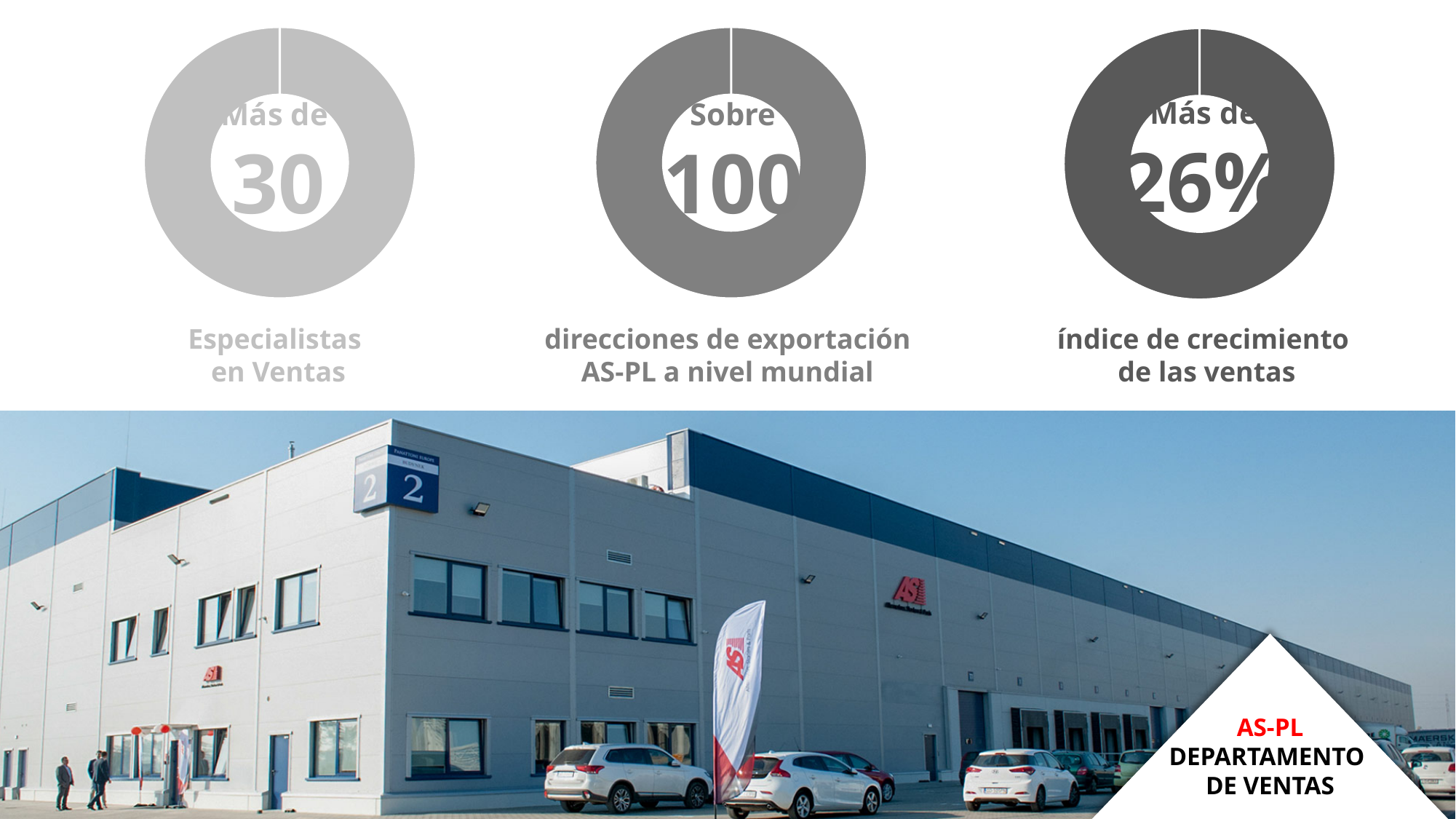
What kind of chart shapes are used to display the three figures at the top of the slide? Donut (ring) charts What value is shown in the right circle labelled 'índice de crecimiento de las ventas'? 26% What number is shown in the left circle labelled 'Especialistas en Ventas'? 30 What qualifier appears above the number 100 in the middle circle? Sobre What is the caption under the right circle showing 26%? índice de crecimiento de las ventas What number is shown in the middle circle labelled 'direcciones de exportación AS-PL a nivel mundial'? 100 What qualifier appears above the 26% in the right circle? Más de How many circular infographic charts are shown at the top of the slide? 3 Which figure is larger: the number of sales specialists or the number of export destinations? Export destinations (100) Which of the three circles is the darkest grey? The right circle (26%) What qualifier appears above the number 30 in the left circle? Más de